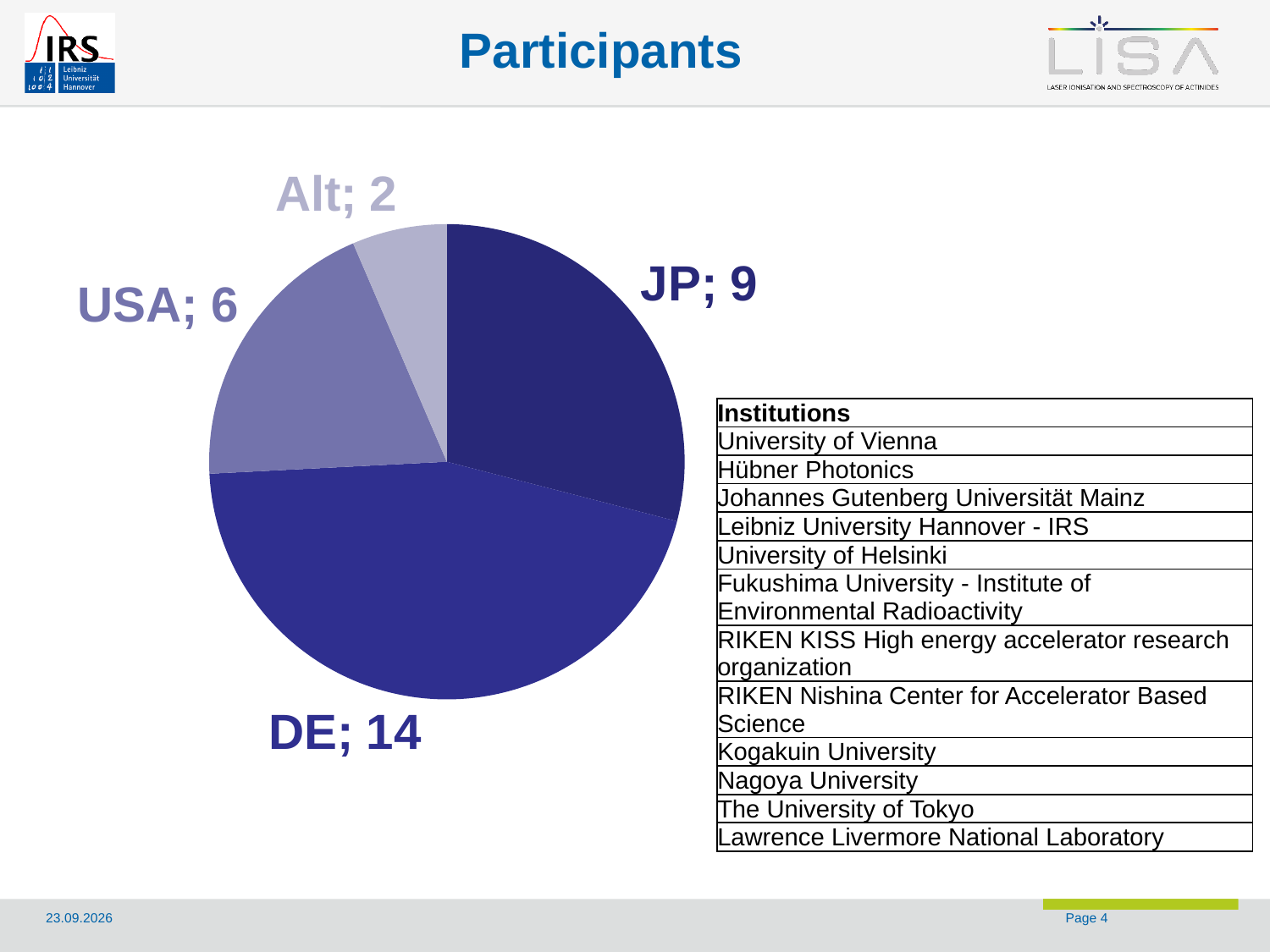
Which category has the largest slice in the pie chart? DE What is the total number of participants across all slices of the pie chart? 31 How many participants are from the USA according to the pie chart? 6 What is the difference between the DE and JP values in the pie chart? 5 What is the title of the slide containing the pie chart? Participants How many slices does the pie chart have? 4 How many participants are from DE according to the pie chart? 14 How many participants are from JP according to the pie chart? 9 What value is shown for the 'Alt' slice of the pie chart? 2 Which category has the smallest slice in the pie chart? Alt What type of chart is shown on the slide? pie chart Which is larger in the pie chart, the USA value or the JP value? JP